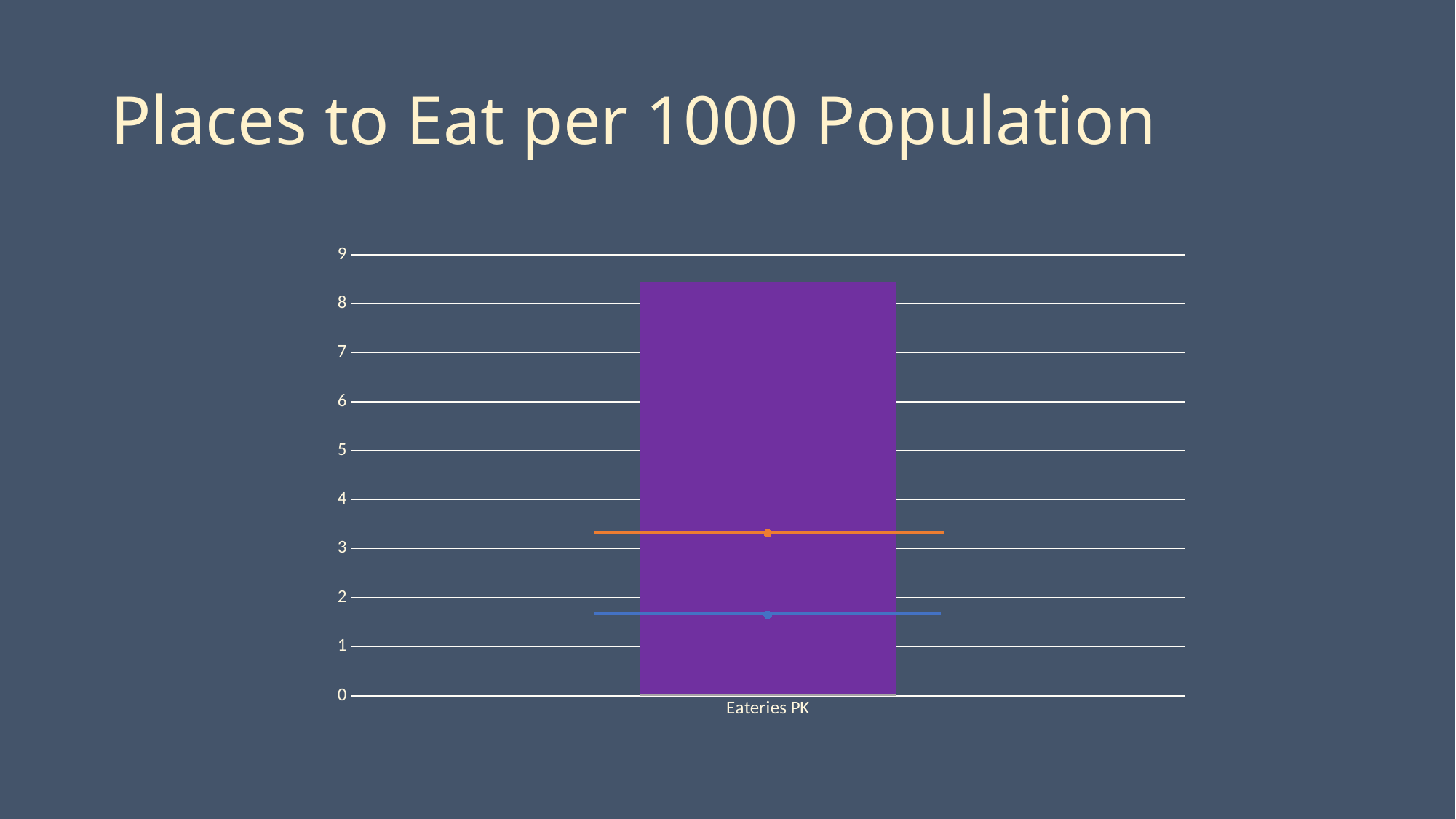
What is the title of the slide's chart? Places to Eat per 1000 Population How many categories are shown on the x axis of the chart? 1 Which is larger, the value of the purple bar or the value marked by the orange line? the purple bar Is the value marked by the blue line greater or less than 1? greater Is the value marked by the orange line greater or less than 3? greater What is the label of the single category on the x axis? Eateries PK Is the value of the purple bar for Eateries PK greater or less than 9? less What kind of chart is shown on the slide? bar chart Which is higher on the chart, the orange line marker or the blue line marker? the orange line marker